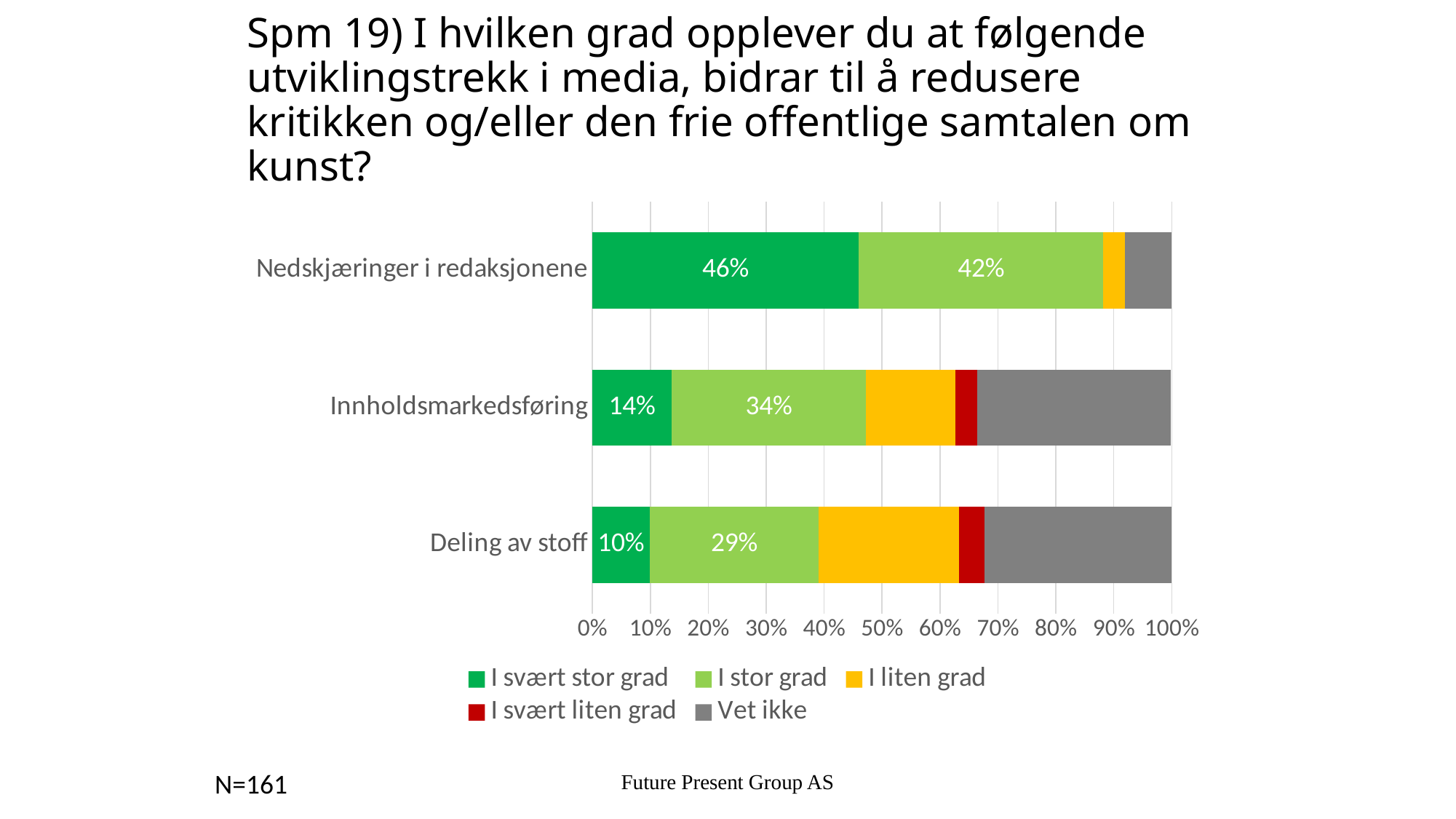
What is the value of "I stor grad" for Innholdsmarkedsføring? 34% What is the value of "I stor grad" for Deling av stoff? 29% What percentage of respondents answered "I svært stor grad" for Nedskjæringer i redaksjonene? 46% Which has a larger "I stor grad" share: Nedskjæringer i redaksjonene or Innholdsmarkedsføring? Nedskjæringer i redaksjonene What is the value of "I svært stor grad" for Deling av stoff? 10% How many categories are shown on the chart? 3 Which category has the highest share of "I svært stor grad"? Nedskjæringer i redaksjonene Is the "Vet ikke" share for Nedskjæringer i redaksjonene greater or less than 10%? less Which category has the lowest share of "I stor grad"? Deling av stoff How many series does the legend list? 5 What is the difference between the "I svært stor grad" values for Nedskjæringer i redaksjonene and Innholdsmarkedsføring? 32 percentage points What kind of chart is shown on the slide? Stacked bar chart